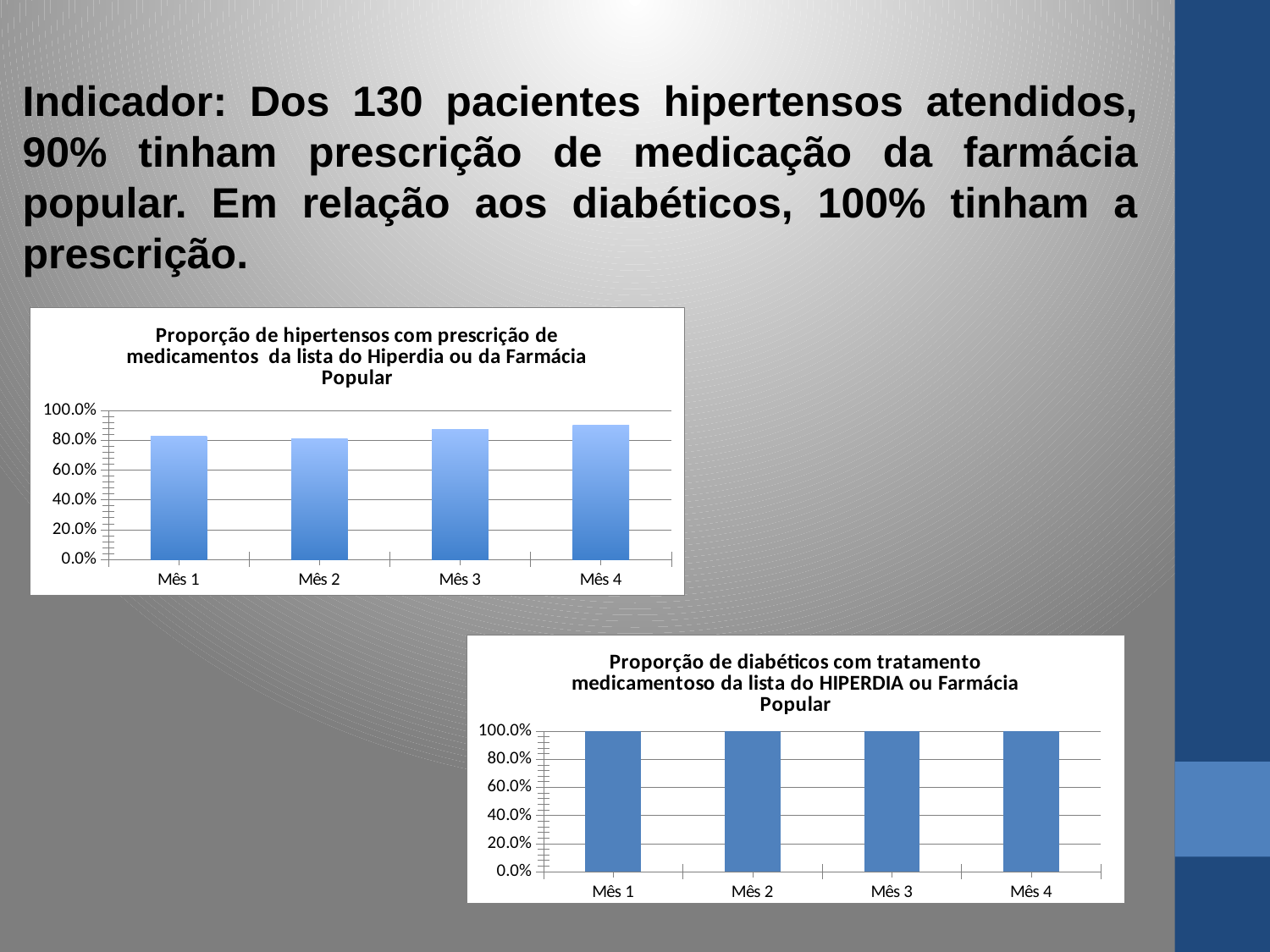
How many categories are shown on the x axis of the top chart about hipertensos? 4 How many categories are shown on the x axis of the bottom chart about diabéticos? 4 In the top chart about hipertensos, is the value for Mês 2 greater or less than 60.0%? greater In the top chart about hipertensos, which is larger, the value for Mês 4 or the value for Mês 2? Mês 4 In the top chart about hipertensos, is the value for Mês 1 greater or less than 60.0%? greater What kind of chart is the top chart, 'Proporção de hipertensos com prescrição de medicamentos da lista do Hiperdia ou da Farmácia Popular'? bar chart In the bottom chart about diabéticos, what is the value for Mês 1? 100.0% In the bottom chart about diabéticos, do the values rise, fall or stay the same from Mês 1 to Mês 4? stay the same In the bottom chart about diabéticos, what is the value for Mês 4? 100.0% What kind of chart is the bottom chart, 'Proporção de diabéticos com tratamento medicamentoso da lista do HIPERDIA ou Farmácia Popular'? bar chart What is the highest value shown on the y axis of the top chart about hipertensos? 100.0% In the top chart about hipertensos, is the value for Mês 4 greater or less than 100.0%? less